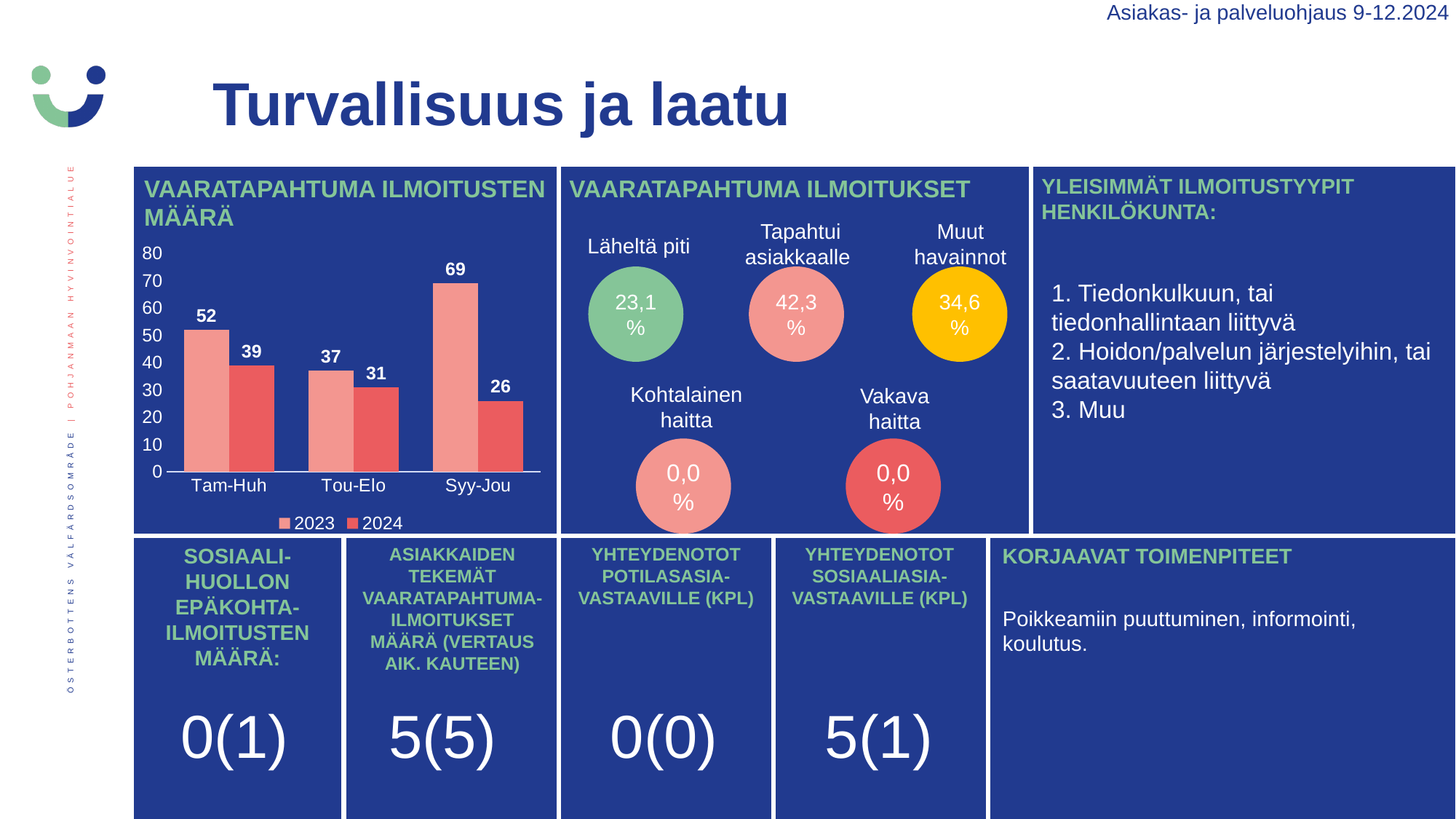
What is the difference between the 2023 and 2024 values for Syy-Jou? 43 What kind of chart is used for VAARATAPAHTUMA ILMOITUSTEN MÄÄRÄ? Bar chart What is the value for Tam-Huh in the 2023 series? 52 Which is larger, the 2023 value for Tou-Elo or the 2024 value for Tam-Huh? 2024 value for Tam-Huh Which category has the lowest value in the 2024 series? Syy-Jou How many categories are shown on the x axis of the bar chart? 3 Do the 2024 values rise or fall from Tam-Huh to Syy-Jou? Fall What is the value for Syy-Jou in the 2024 series? 26 What is the difference between the 2023 and 2024 values for Tam-Huh? 13 Which category has the highest value in the 2023 series? Syy-Jou How many series does the legend of the bar chart list? 2 What is the value for Tou-Elo in the 2024 series? 31